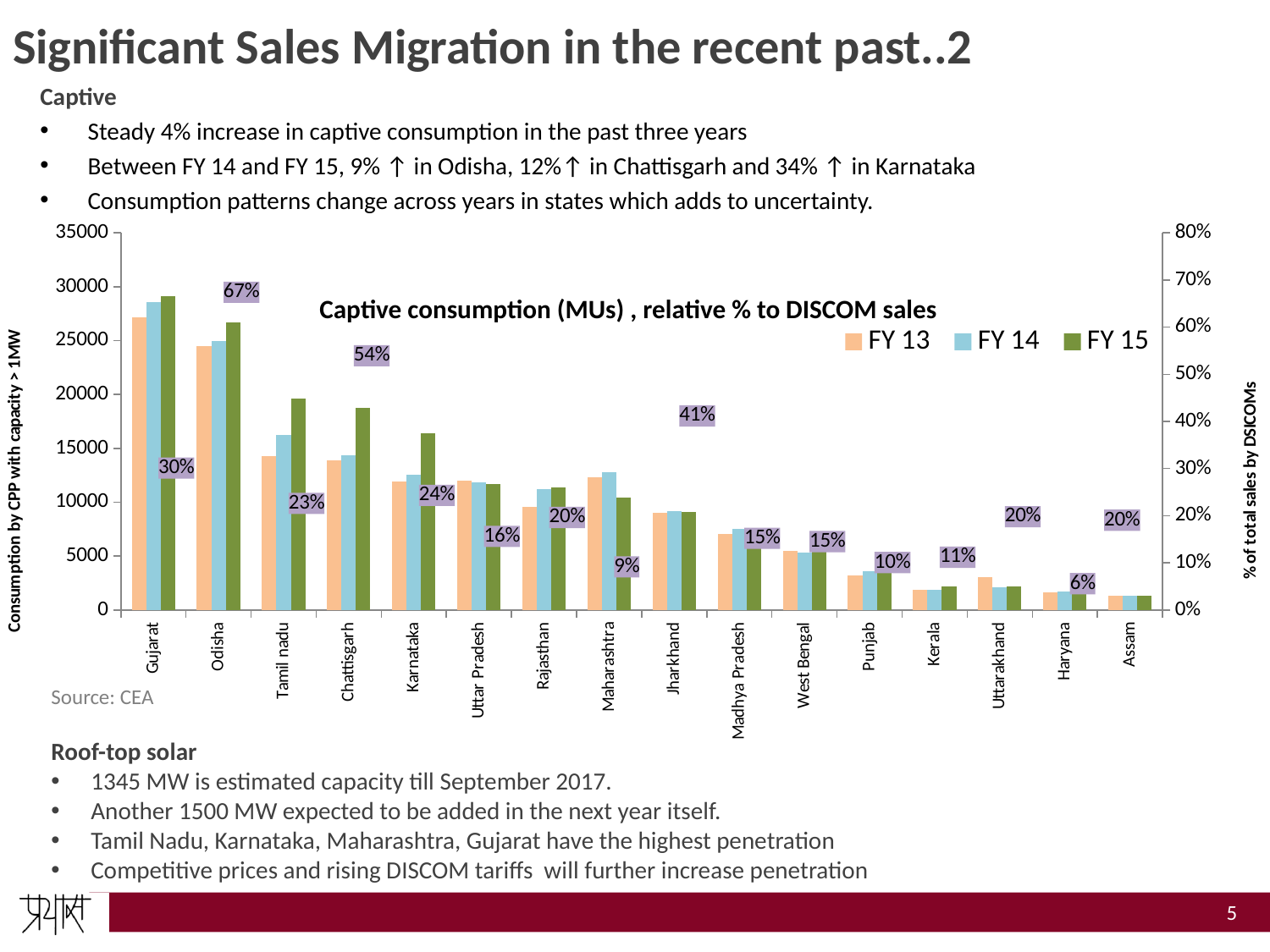
Which state has the larger FY 15 captive consumption, Gujarat or Odisha? Gujarat Which state has the lowest labelled relative % to DISCOM sales? Haryana How many states are shown on the x axis of the chart? 16 What is the relative % to DISCOM sales labelled for Chattisgarh? 54% Which state has the highest labelled relative % to DISCOM sales? Odisha What is the relative % to DISCOM sales labelled for Odisha? 67% What is the difference between the labelled percentages for Odisha and Chattisgarh? 13% What kind of chart is shown on the slide? bar chart What is the relative % to DISCOM sales labelled for Jharkhand? 41% Is the FY 15 captive consumption for Gujarat greater or less than 25000? greater How many series does the chart legend list? 3 What is the title of the chart? Captive consumption (MUs) , relative % to DISCOM sales